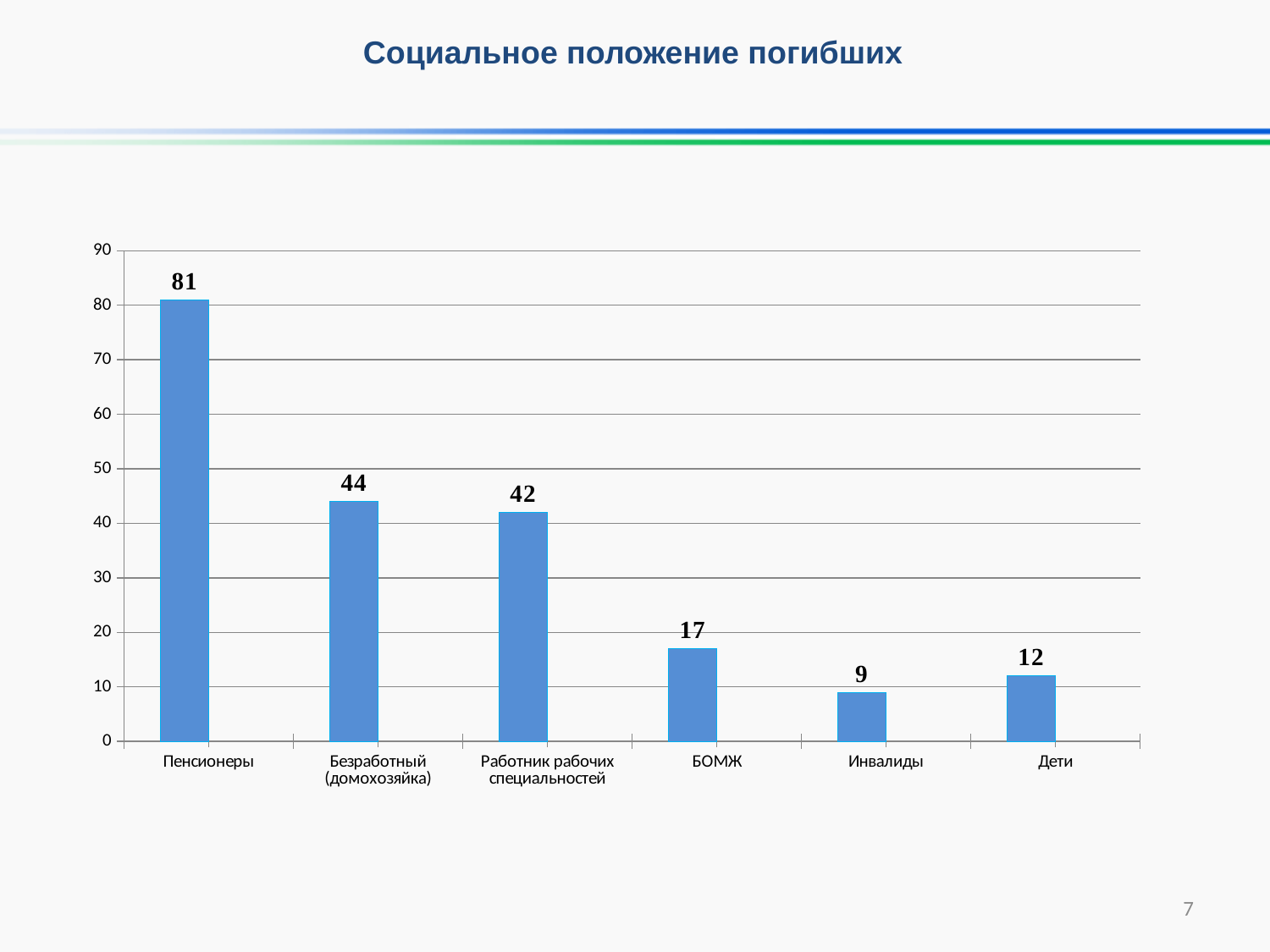
What is the title of the slide? Социальное положение погибших What is the difference between the values for Дети and Инвалиды? 3 Is the value for Работник рабочих специальностей greater or less than 50? less What is the value for Дети? 12 What is the value for Пенсионеры? 81 What kind of chart is shown on the slide? bar chart Which category has the highest value? Пенсионеры How many categories are shown on the x axis? 6 Which is larger, the value for Безработный (домохозяйка) or the value for Работник рабочих специальностей? Безработный (домохозяйка) Which category has the lowest value? Инвалиды What is the value for БОМЖ? 17 What is the difference between the values for Пенсионеры and Безработный (домохозяйка)? 37